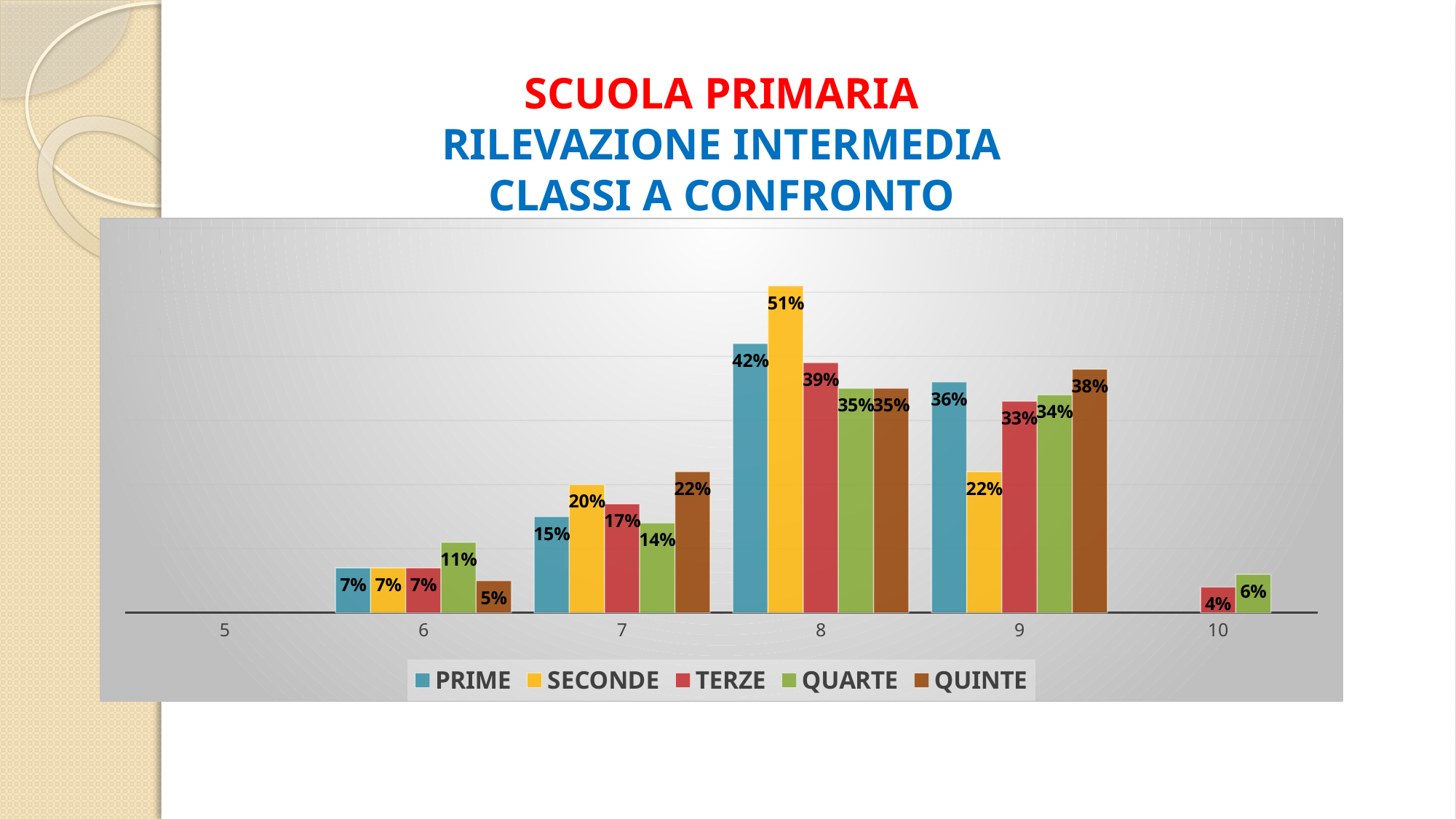
What is the value for TERZE at grade 10? 4% What is the value for SECONDE at grade 8? 51% Which series has the highest value at grade 9? QUINTE What kind of chart is shown on the slide? bar chart What is the difference between the SECONDE value at grade 8 and the SECONDE value at grade 9? 29% Which is larger: the PRIME value at grade 8 or the PRIME value at grade 9? PRIME at grade 8 Which series has the lowest value at grade 6? QUINTE How many series does the legend list? 5 For the SECONDE series, do the values rise or fall from grade 8 to grade 9? fall How many categories are shown on the x axis? 6 Which series is shown in yellow in the legend? SECONDE What is the value for QUINTE at grade 7? 22%